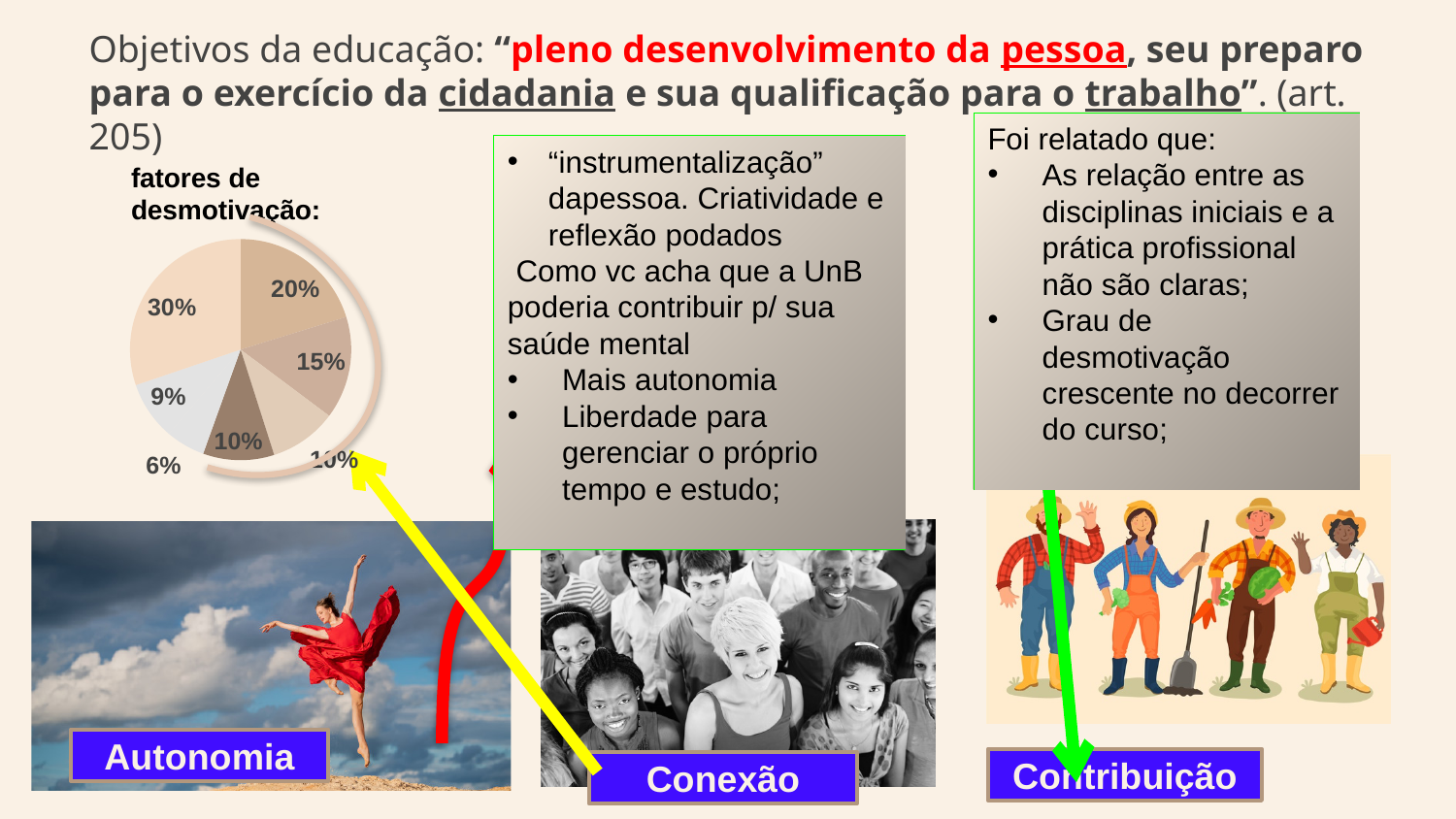
What is the difference between the largest slice (30%) and the smallest slice (6%) in the pie chart? 24 percentage points Is the largest slice of the pie chart greater or less than 25%? greater Which is larger in the pie chart: the slice labeled 15% or the slice labeled 9%? 15% What is the value of the second-largest slice in the pie chart? 20% Does the pie chart include a legend naming the slices? No What is the value of the smallest slice in the pie chart? 6% What is the value of the largest slice in the pie chart? 30% How many slices in the pie chart are labeled 10%? 2 What kind of chart is shown on the slide? pie chart How many slices does the pie chart have? 7 What is the title of the pie chart? fatores de desmotivação: What is the combined share of the two slices labeled 30% and 20% in the pie chart? 50%